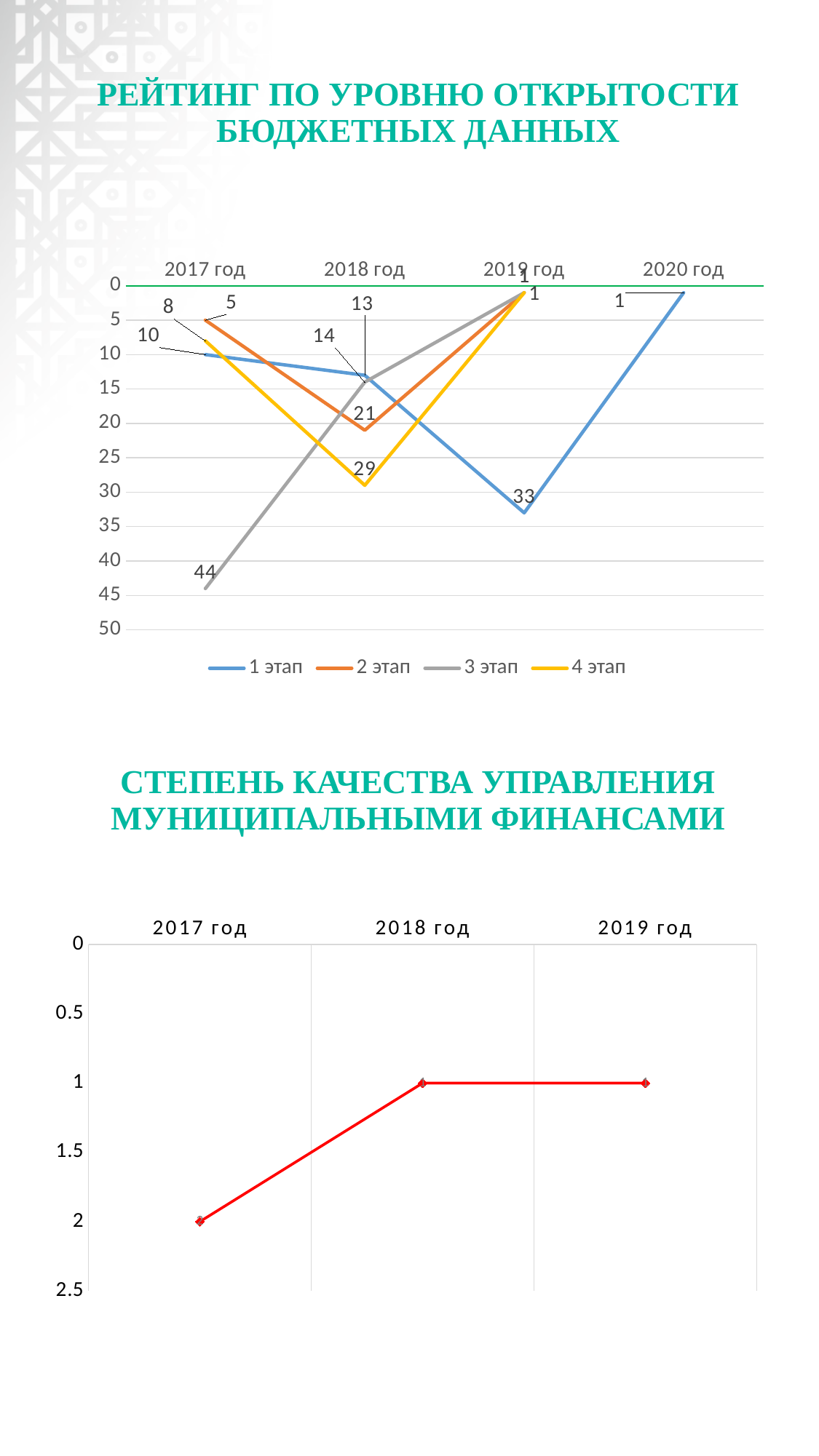
In the top chart 'РЕЙТИНГ ПО УРОВНЮ ОТКРЫТОСТИ БЮДЖЕТНЫХ ДАННЫХ', for 2017 год, which is larger: the value of '3 этап' or '2 этап'? 3 этап How many years are shown on the x axis of the top chart 'РЕЙТИНГ ПО УРОВНЮ ОТКРЫТОСТИ БЮДЖЕТНЫХ ДАННЫХ'? 4 In the top chart 'РЕЙТИНГ ПО УРОВНЮ ОТКРЫТОСТИ БЮДЖЕТНЫХ ДАННЫХ', what is the value of '4 этап' for 2018 год? 29 How many series does the legend of the top chart 'РЕЙТИНГ ПО УРОВНЮ ОТКРЫТОСТИ БЮДЖЕТНЫХ ДАННЫХ' list? 4 In the top chart 'РЕЙТИНГ ПО УРОВНЮ ОТКРЫТОСТИ БЮДЖЕТНЫХ ДАННЫХ', what is the value of '3 этап' for 2017 год? 44 In the top chart 'РЕЙТИНГ ПО УРОВНЮ ОТКРЫТОСТИ БЮДЖЕТНЫХ ДАННЫХ', what is the difference between the '1 этап' values for 2019 год and 2020 год? 32 In the top chart 'РЕЙТИНГ ПО УРОВНЮ ОТКРЫТОСТИ БЮДЖЕТНЫХ ДАННЫХ', which series has the highest value for 2018 год? 4 этап What kind of chart is the top chart, 'РЕЙТИНГ ПО УРОВНЮ ОТКРЫТОСТИ БЮДЖЕТНЫХ ДАННЫХ'? line chart How many data points are plotted in the bottom chart 'СТЕПЕНЬ КАЧЕСТВА УПРАВЛЕНИЯ МУНИЦИПАЛЬНЫМИ ФИНАНСАМИ'? 3 In the bottom chart 'СТЕПЕНЬ КАЧЕСТВА УПРАВЛЕНИЯ МУНИЦИПАЛЬНЫМИ ФИНАНСАМИ', what is the value for 2017 год? 2 In the top chart 'РЕЙТИНГ ПО УРОВНЮ ОТКРЫТОСТИ БЮДЖЕТНЫХ ДАННЫХ', what is the value of '1 этап' for 2019 год? 33 In the top chart 'РЕЙТИНГ ПО УРОВНЮ ОТКРЫТОСТИ БЮДЖЕТНЫХ ДАННЫХ', what is the value of '2 этап' for 2018 год? 21